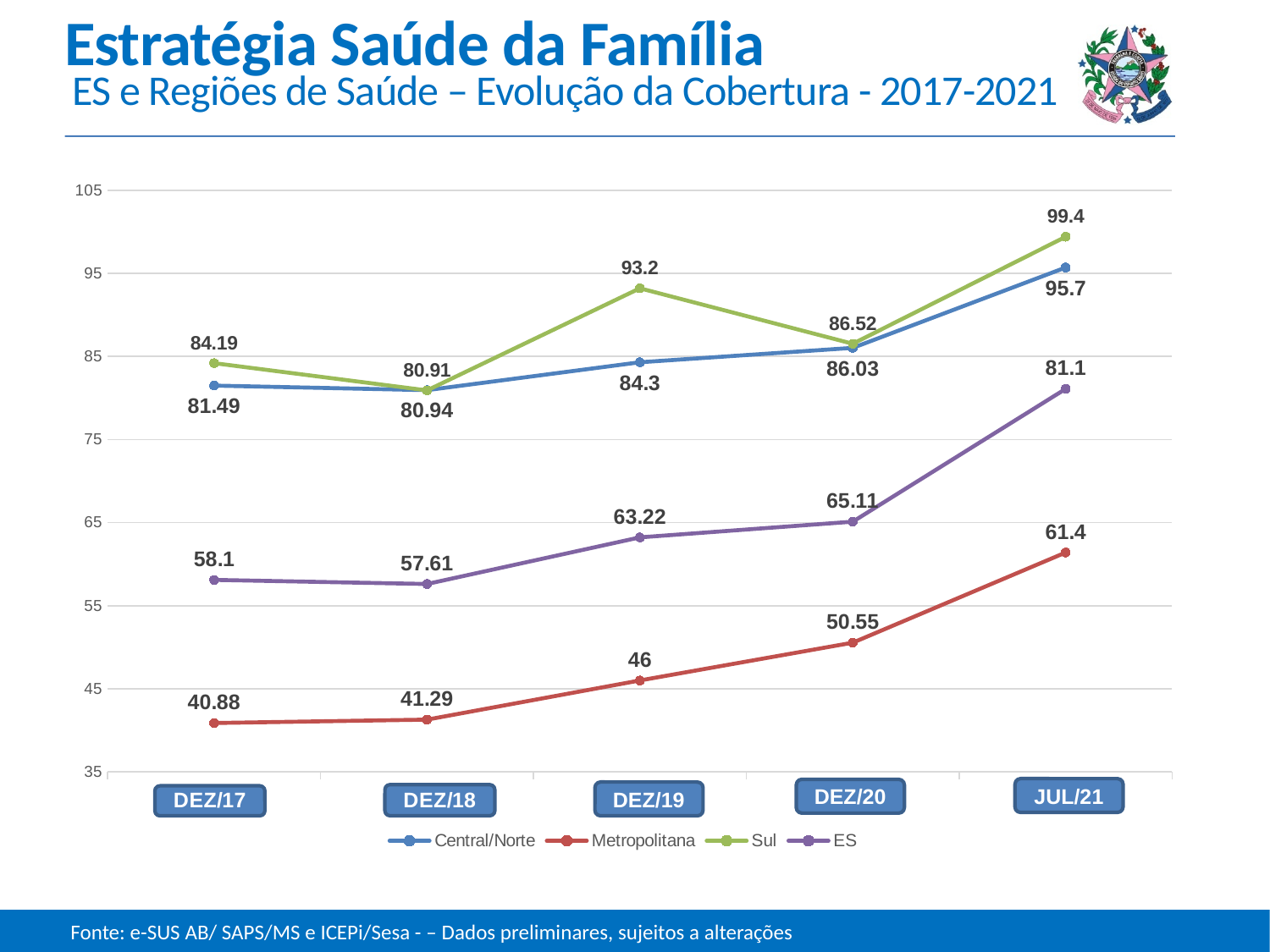
Which is larger at DEZ/20, the value for ES or the value for Metropolitana? ES Which series has the highest value at JUL/21? Sul What is the difference between the Sul and Central/Norte values at JUL/21? 3.7 Does the Metropolitana line rise or fall from DEZ/17 to JUL/21? rise What is the value for Sul at DEZ/19? 93.2 How many time points are shown on the x axis? 5 How many series does the legend list? 4 What is the value for Metropolitana at DEZ/19? 46 What colour is the Metropolitana line in the legend? red What is the value for ES at JUL/21? 81.1 At which time point does Metropolitana have its lowest value? DEZ/17 What kind of chart is shown on the slide? line chart